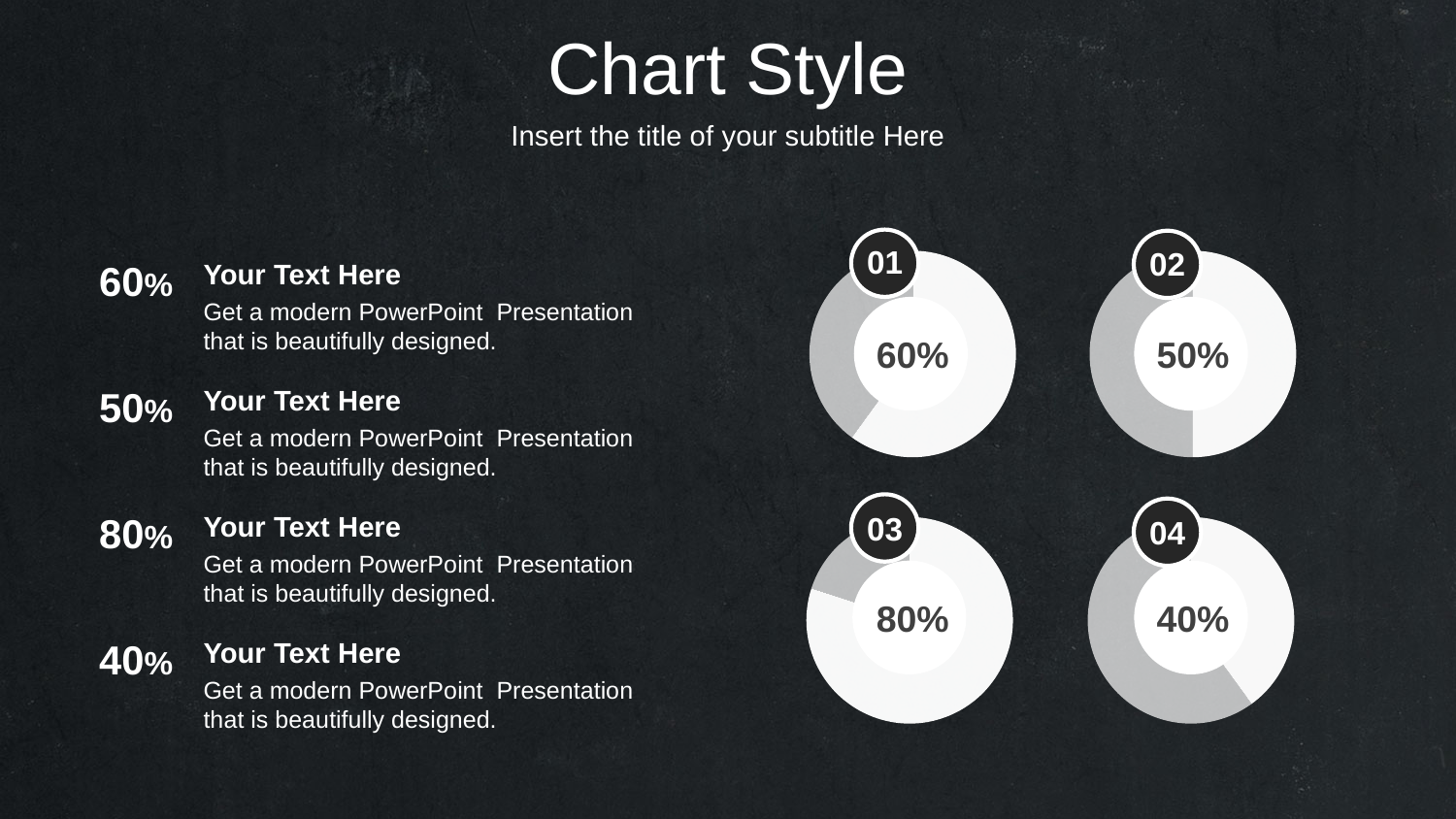
What value is shown in the centre of donut chart 01? 60% What value is shown in the centre of donut chart 02? 50% Which of the four numbered donut charts shows the lowest percentage? 04 How many donut charts are on the slide? 4 What value is shown in the centre of donut chart 03? 80% Which of the four numbered donut charts shows the highest percentage? 03 What is the difference between the percentage in donut chart 01 and the percentage in donut chart 02? 10% Which shows a larger percentage, donut chart 01 or donut chart 02? 01 What value is shown in the centre of donut chart 04? 40% What is the difference between the percentage in donut chart 03 and the percentage in donut chart 04? 40% What kind of chart is used for the four numbered graphics on the right of the slide? Donut chart What is the title of the slide containing the four donut charts? Chart Style